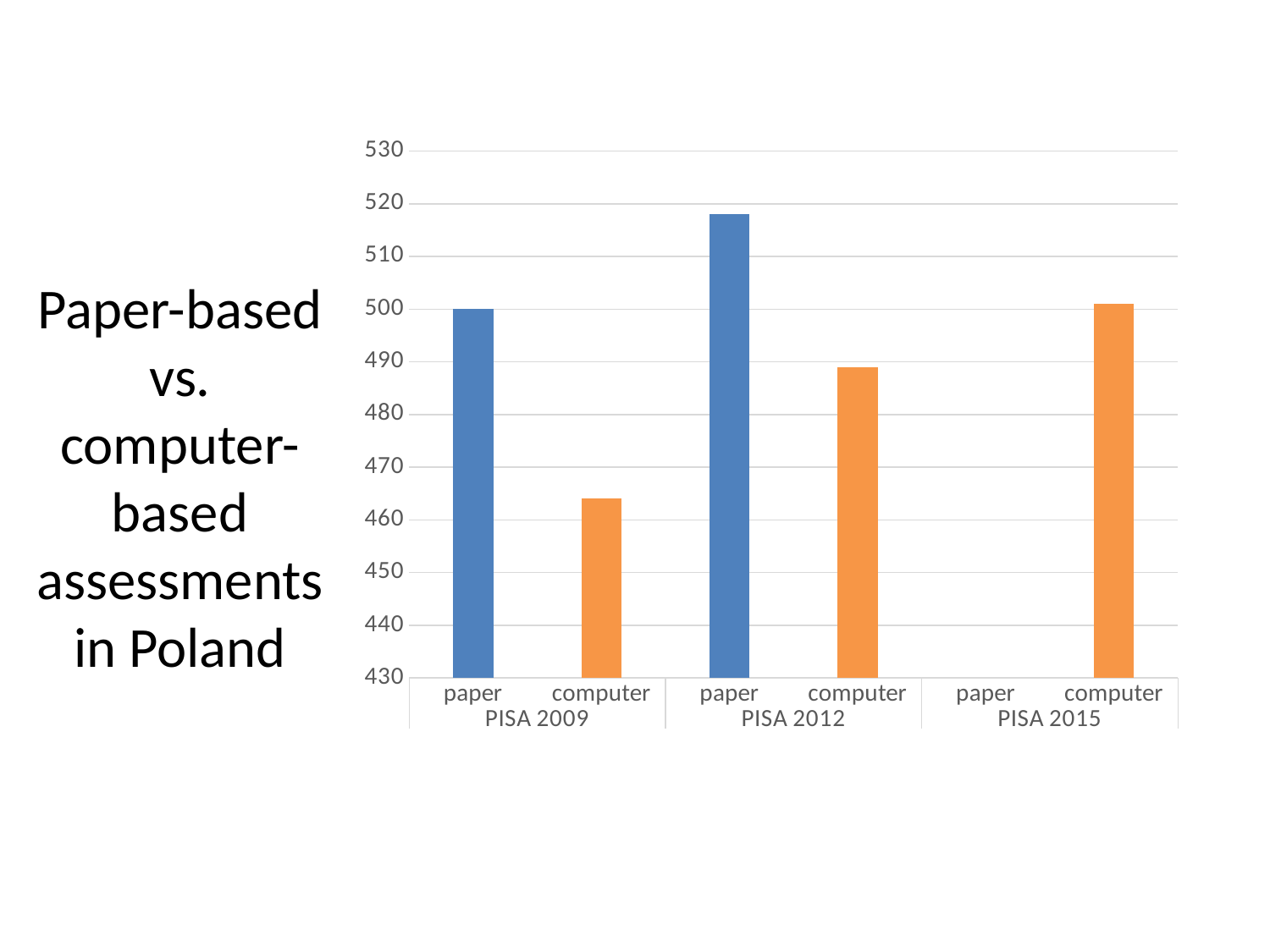
Is the value for the PISA 2012 paper bar greater or less than 510? greater Is the value for the PISA 2009 computer bar greater or less than 460? greater Which bar is the lowest in the chart? PISA 2009 computer Which is larger, the PISA 2009 computer bar or the PISA 2015 computer bar? PISA 2015 computer How many PISA rounds are shown on the x axis? 3 Which PISA round has no paper bar plotted? PISA 2015 Which bar is the highest in the chart? PISA 2012 paper What kind of chart is shown on the slide? bar chart Which is larger, the PISA 2012 paper bar or the PISA 2012 computer bar? PISA 2012 paper Is the value for the PISA 2015 computer bar greater or less than 510? less